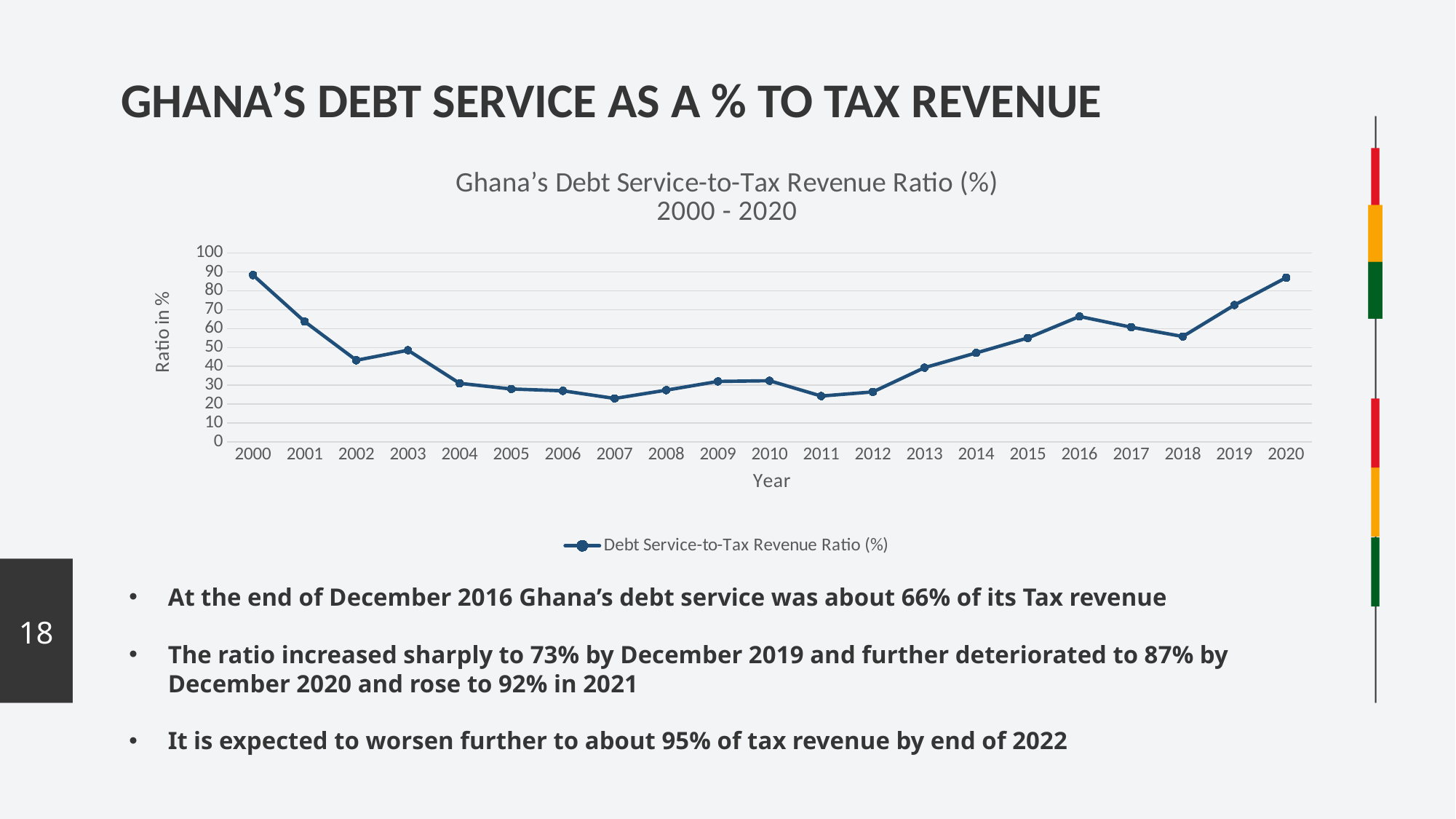
Do the values rise or fall from 2000 to 2007? fall How many years (data points) are plotted on the chart? 21 What kind of chart is shown on the slide? line chart How many series does the chart legend list? 1 Is the value for 2012 greater or less than 30? less Which year has the larger value, 2000 or 2010? 2000 Is the value for 2016 greater or less than 60? greater Is the value for 2007 greater or less than 30? less What is the label on the vertical axis of the chart? Ratio in % Which year has the larger value, 2016 or 2018? 2016